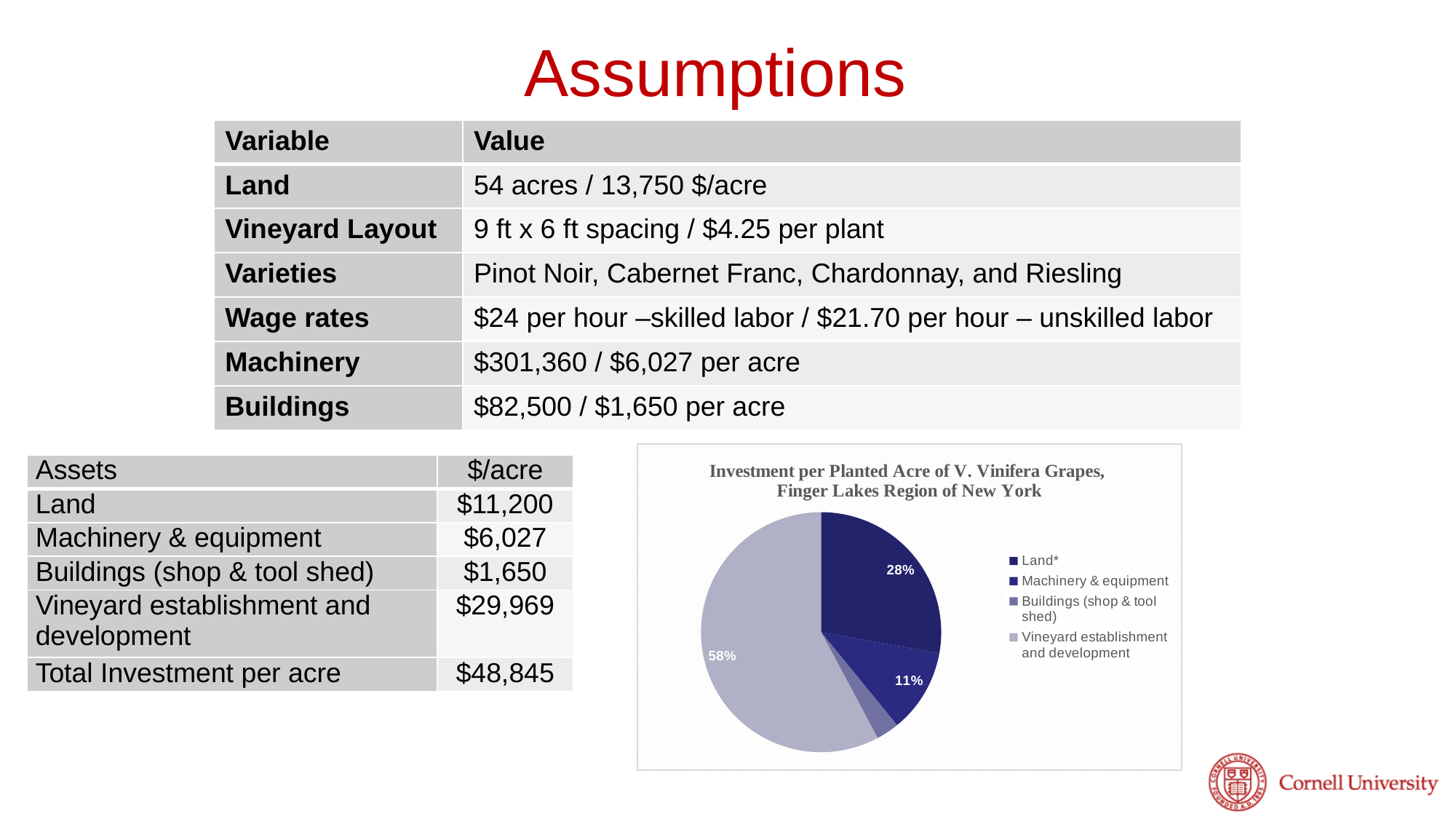
What is the difference in percentage points between the Vineyard establishment and development slice and the Land* slice? 30% Which category has the smallest slice of the pie? Buildings (shop & tool shed) Which slice is larger, Land* or Machinery & equipment? Land* What share of the pie does Machinery & equipment represent? 11% What share of the pie does Land* represent? 28% How many entries does the legend of the pie chart list? 4 What type of chart is shown on the slide? pie chart How many slices does the pie chart have? 4 What share of the pie does Vineyard establishment and development represent? 58% Is the share for Vineyard establishment and development greater or less than 50%? greater What is the title of the pie chart? Investment per Planted Acre of V. Vinifera Grapes, Finger Lakes Region of New York Which category has the largest slice of the pie? Vineyard establishment and development